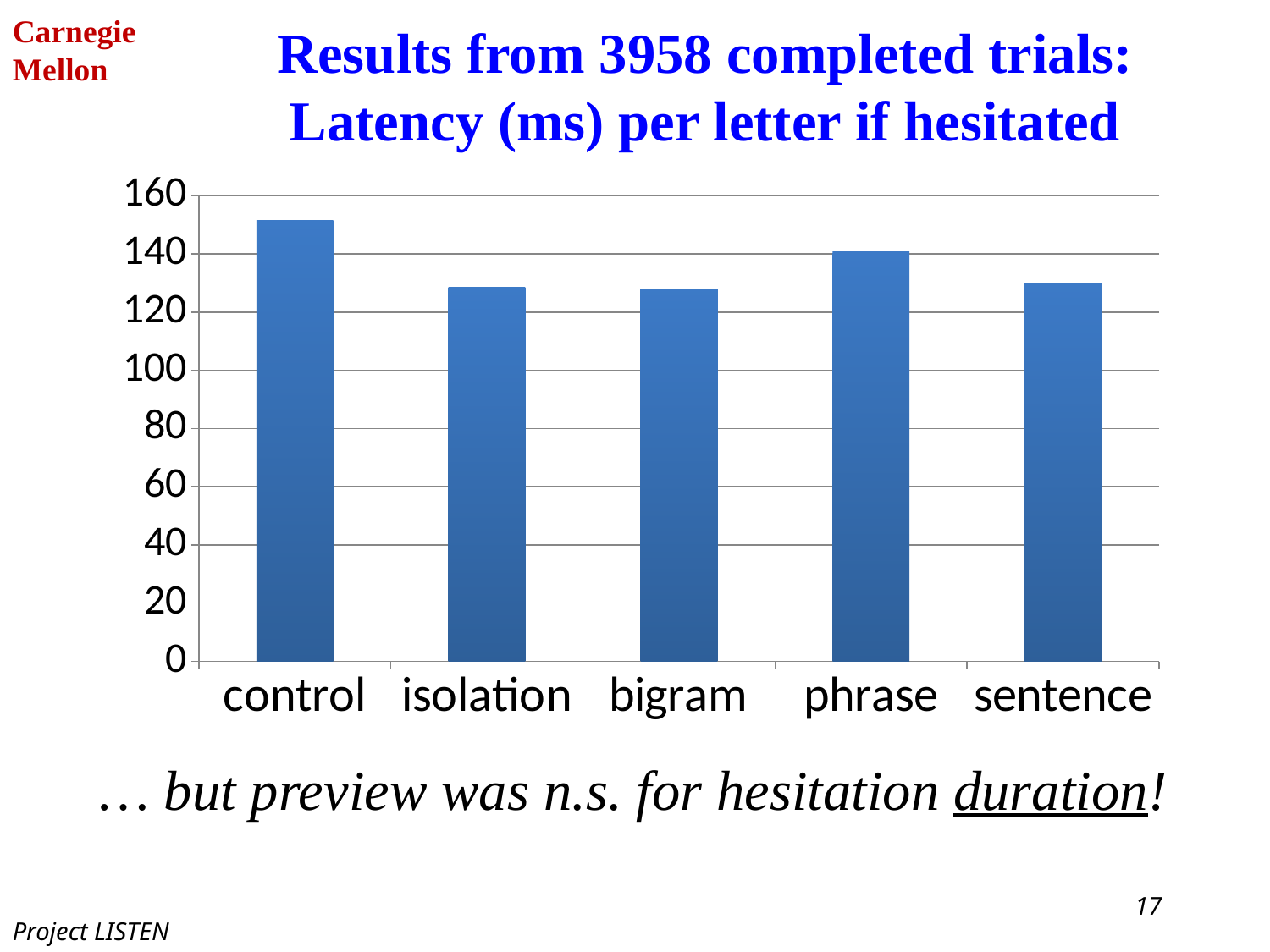
Is the value for bigram greater or less than 140? less Is the value for control greater or less than 140? greater What kind of chart is shown on the slide? bar chart Is the value for isolation greater or less than 140? less Which category has the highest latency in the chart? control What is the highest value shown on the y axis of the chart? 160 How many categories are shown on the x axis of the chart? 5 What is the title of the chart on the slide? Results from 3958 completed trials: Latency (ms) per letter if hesitated Which has a larger value, phrase or isolation? phrase Which has a larger value, control or phrase? control